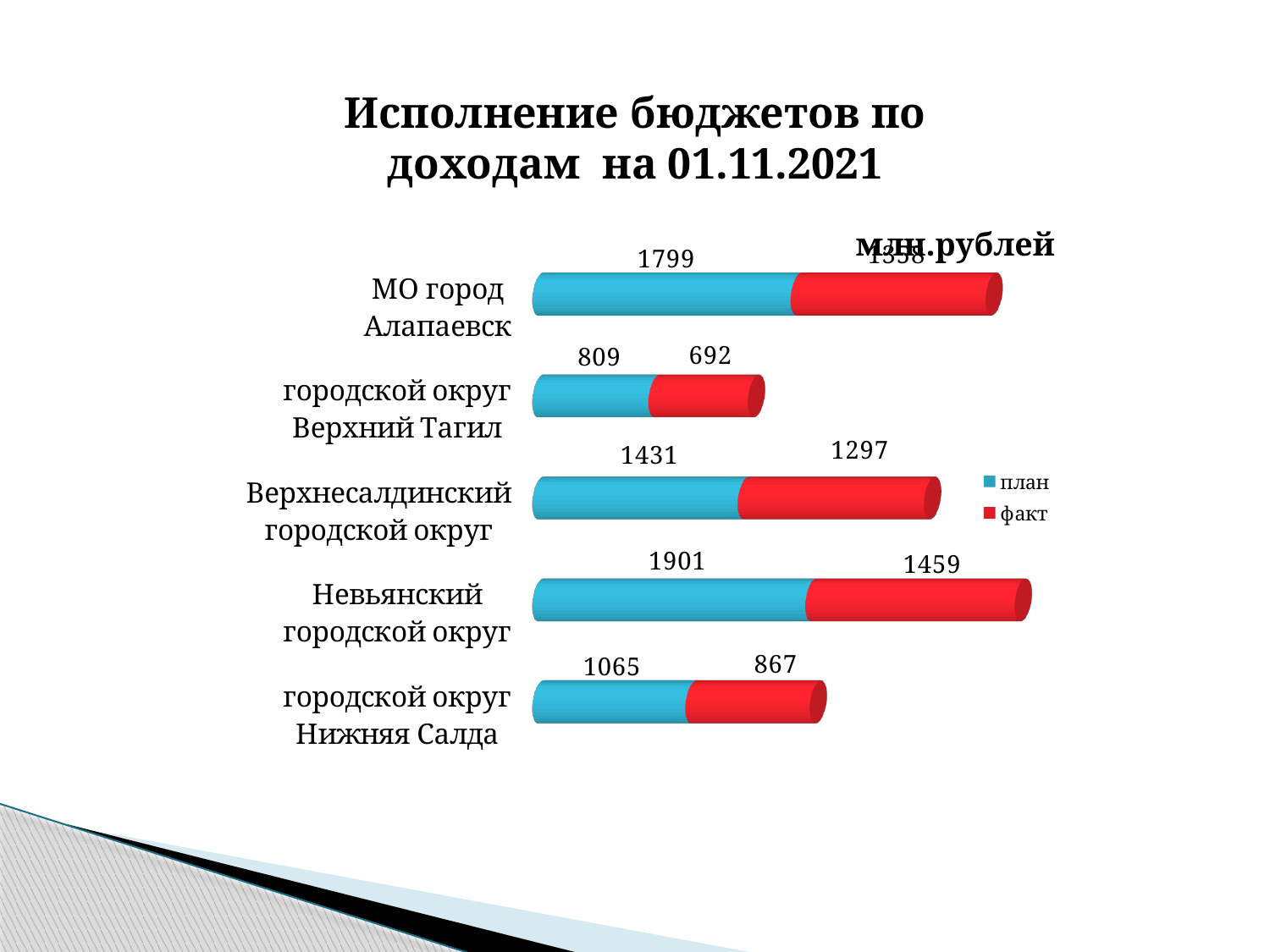
Which category has the lowest план value? городской округ Верхний Тагил What is the план value for МО город Алапаевск? 1799 What kind of chart is shown on the slide? bar chart Which is larger, the план value for Верхнесалдинский городской округ or the план value for городской округ Нижняя Салда? Верхнесалдинский городской округ What is the факт value for городской округ Нижняя Салда? 867 What is the difference between план and факт for Невьянский городской округ? 442 What is the total of the stacked bar for городской округ Верхний Тагил? 1501 How many categories are shown on the chart? 5 What is the план value for Невьянский городской округ? 1901 How many series does the legend list? 2 What is the факт value for городской округ Верхний Тагил? 692 Which category has the highest план value? Невьянский городской округ